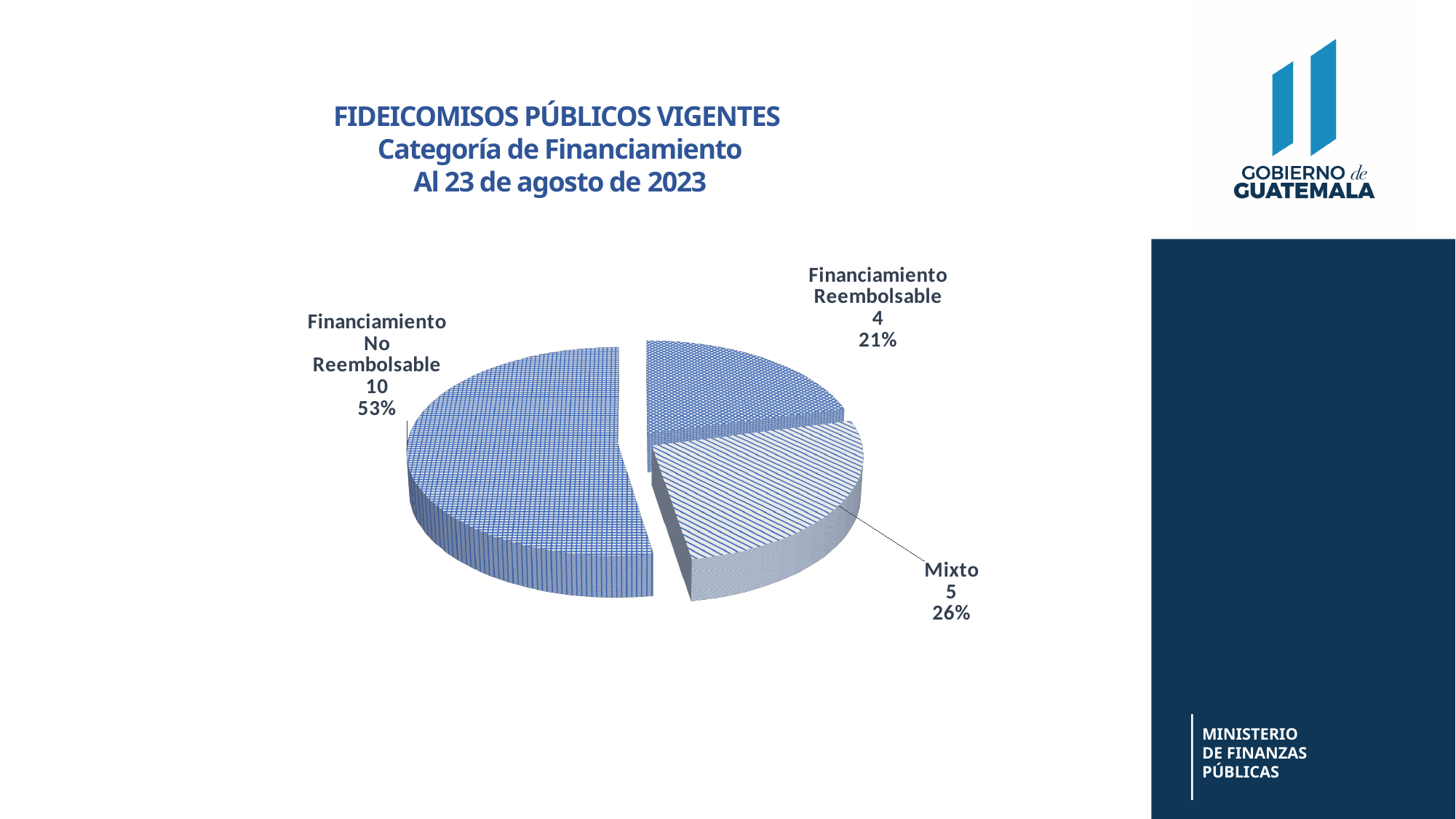
How many fideicomisos are in the Financiamiento No Reembolsable category? 10 What percentage share does the Financiamiento Reembolsable slice represent? 21% What kind of chart is shown on the slide? Pie chart Which category has the smallest number of fideicomisos? Financiamiento Reembolsable What is the difference in the number of fideicomisos between Financiamiento No Reembolsable and Mixto? 5 What percentage share does the Mixto slice represent? 26% How many fideicomisos are in the Mixto category? 5 What percentage share does the Financiamiento No Reembolsable slice represent? 53% Which has more fideicomisos, Mixto or Financiamiento Reembolsable? Mixto How many fideicomisos are in the Financiamiento Reembolsable category? 4 Which category has the largest number of fideicomisos? Financiamiento No Reembolsable How many categories does the pie chart show? 3